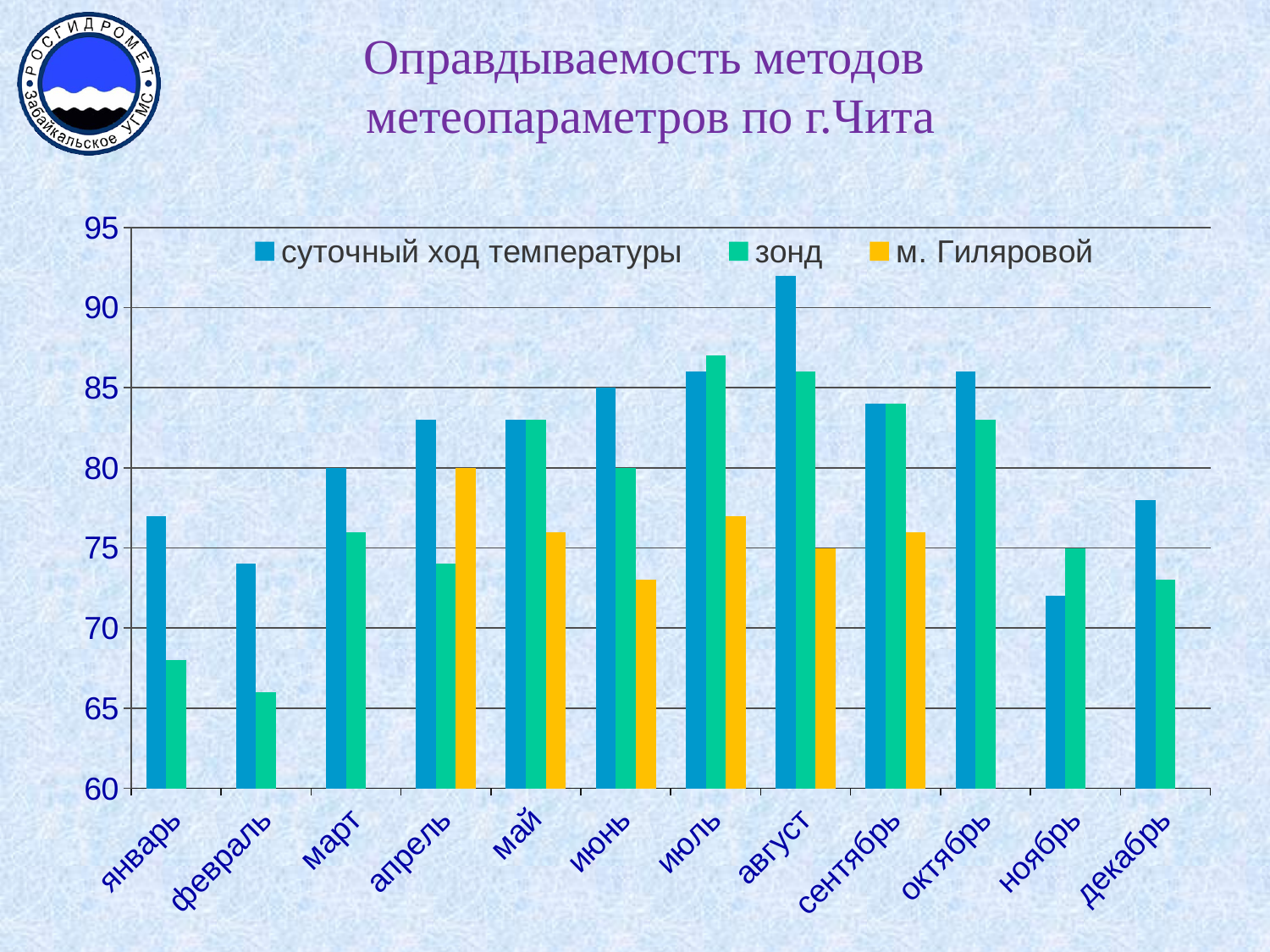
How many series does the legend list? 3 Is the value for зонд in февраль greater or less than 70? less What is the value for суточный ход температуры in июнь? 85 Is the value for суточный ход температуры in декабрь greater or less than 75? greater What kind of chart is shown on the slide? bar chart How many months are shown on the x axis? 12 In which month is the value for зонд the lowest? февраль Is the value for суточный ход температуры in январь greater or less than 75? greater In август, which is larger: суточный ход температуры or зонд? суточный ход температуры In which month is the value for суточный ход температуры the highest? август What is the value for суточный ход температуры in март? 80 What colour are the bars for м. Гиляровой? yellow